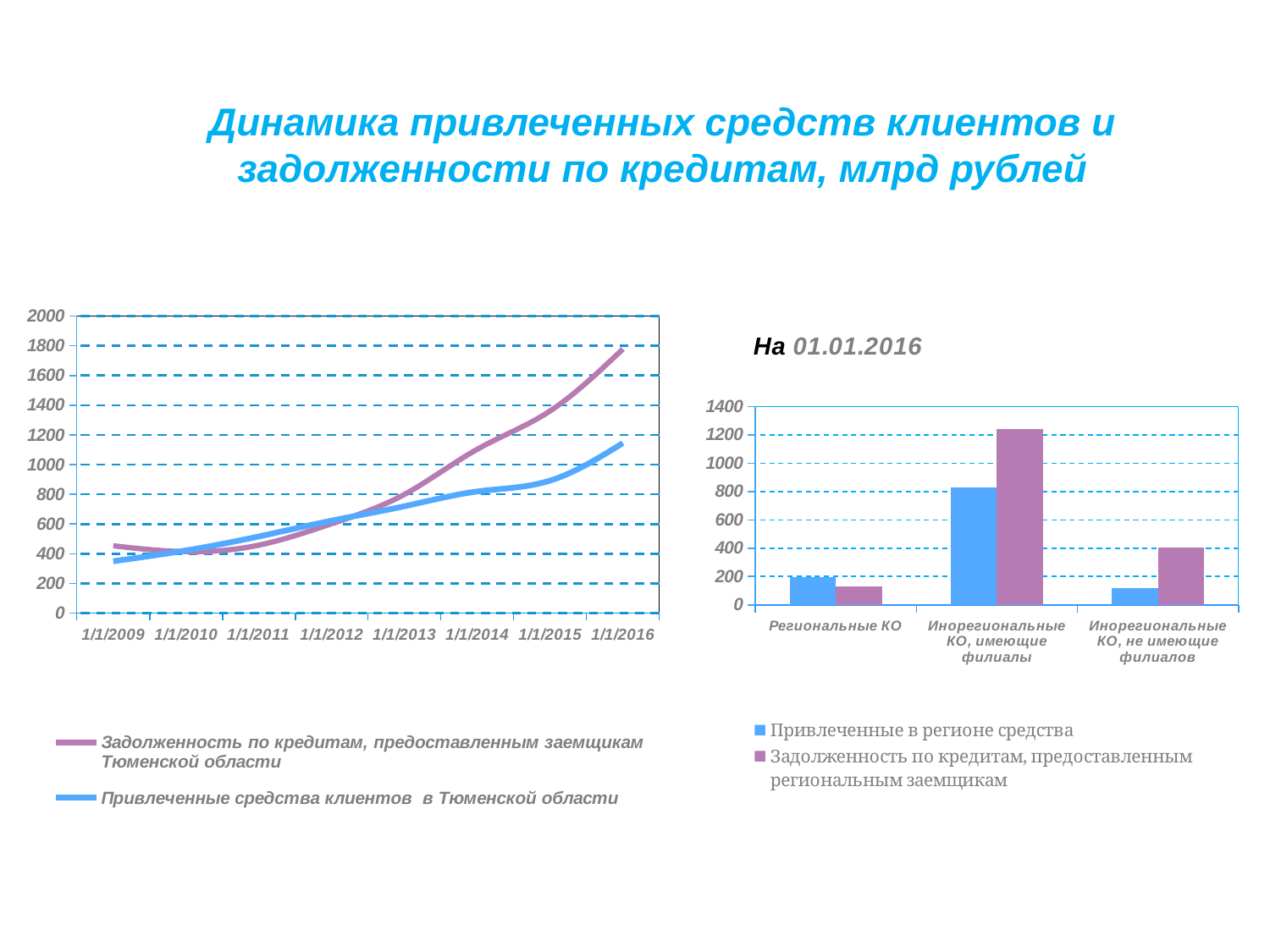
In the left line chart, which series has the higher value at 1/1/2016? Задолженность по кредитам, предоставленным заемщикам Тюменской области In the left line chart, is the value for "Задолженность по кредитам, предоставленным заемщикам Тюменской области" at 1/1/2016 greater or less than 1600? greater What kind of chart is the chart titled "На 01.01.2016" on the right? bar chart In the left line chart, how many dates are shown on the x axis? 8 In the left line chart, is the value for "Привлеченные средства клиентов в Тюменской области" at 1/1/2016 greater or less than 1200? less In the chart titled "На 01.01.2016", is the value of "Привлеченные в регионе средства" for "Инорегиональные КО, имеющие филиалы" greater or less than 800? greater In the chart titled "На 01.01.2016", how many categories are shown on the x axis? 3 In the chart titled "На 01.01.2016", which category has the highest value for "Задолженность по кредитам, предоставленным региональным заемщикам"? Инорегиональные КО, имеющие филиалы In the left line chart, how many series does the legend list? 2 What kind of chart is the chart on the left side of the slide? line chart In the chart titled "На 01.01.2016", for "Инорегиональные КО, не имеющие филиалов", which series has the larger value? Задолженность по кредитам, предоставленным региональным заемщикам In the left line chart, does the value for "Задолженность по кредитам, предоставленным заемщикам Тюменской области" rise or fall from 1/1/2011 to 1/1/2016? rise